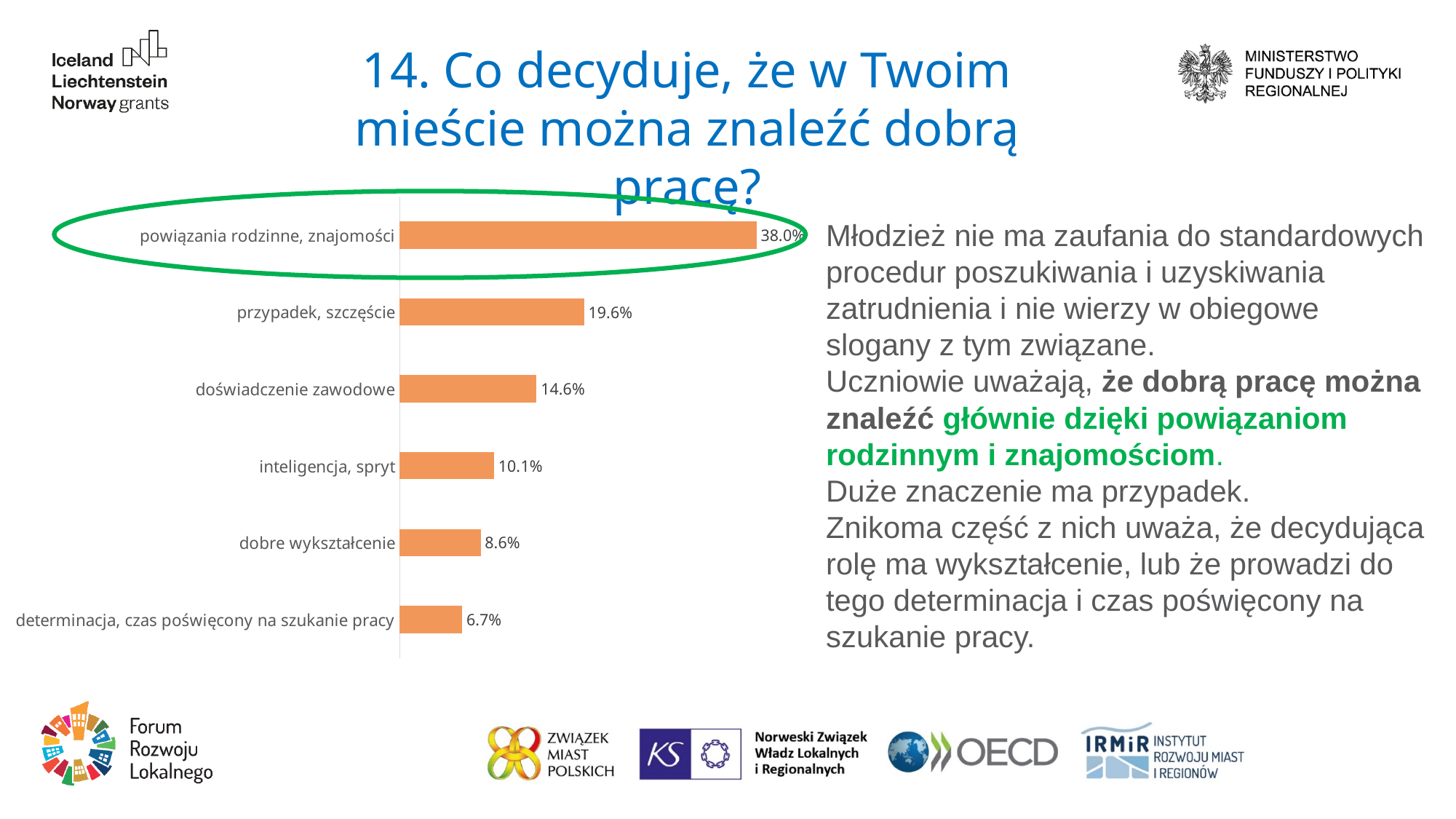
What is the value for "powiązania rodzinne, znajomości"? 38.0% Which is larger: the value for "inteligencja, spryt" or the value for "dobre wykształcenie"? inteligencja, spryt What is the difference between the values for "powiązania rodzinne, znajomości" and "przypadek, szczęście"? 18.4% What is the value for "doświadczenie zawodowe"? 14.6% Which category on the chart is circled in green? powiązania rodzinne, znajomości Which category has the highest value? powiązania rodzinne, znajomości What is the value for "przypadek, szczęście"? 19.6% What is the difference between the values for "doświadczenie zawodowe" and "determinacja, czas poświęcony na szukanie pracy"? 7.9% What is the value for "dobre wykształcenie"? 8.6% What kind of chart is shown on the slide? bar chart How many categories are shown in the chart? 6 Which category has the lowest value? determinacja, czas poświęcony na szukanie pracy